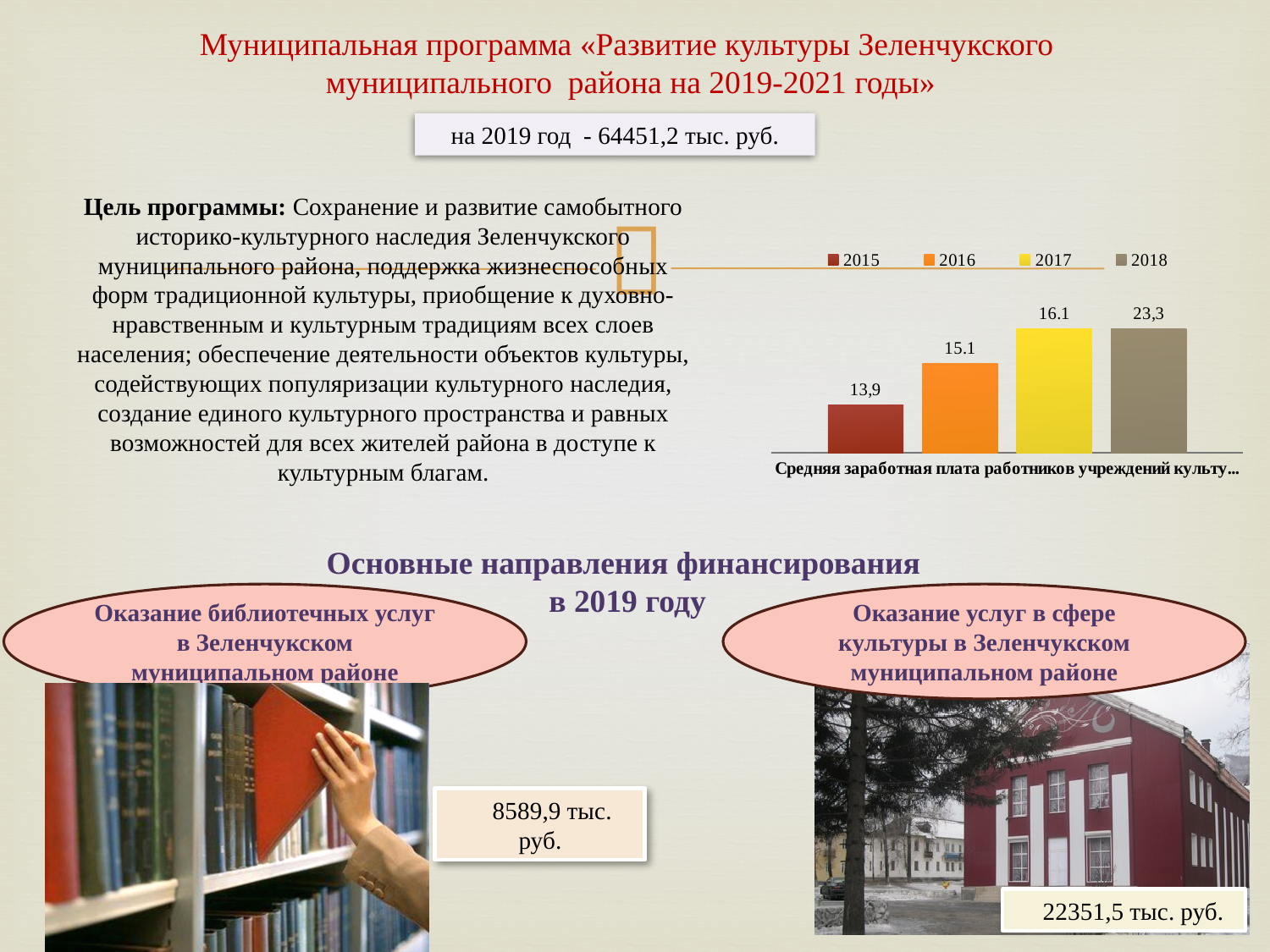
Do the values in the chart rise or fall from 2015 to 2018? rise Which year has the lowest value in the chart? 2015 What is the value shown for 2015 in the chart? 13,9 Which year has the highest value in the chart? 2018 What type of chart is shown on the slide? bar chart How many bars are plotted in the chart? 4 What is the value shown for 2016 in the chart? 15.1 What is the value shown for 2017 in the chart? 16.1 How many entries does the chart legend list? 4 What is the value shown for 2018 in the chart? 23,3 What is the difference between the values for 2018 and 2015? 9,4 Which is larger, the value for 2017 or the value for 2016? 2017